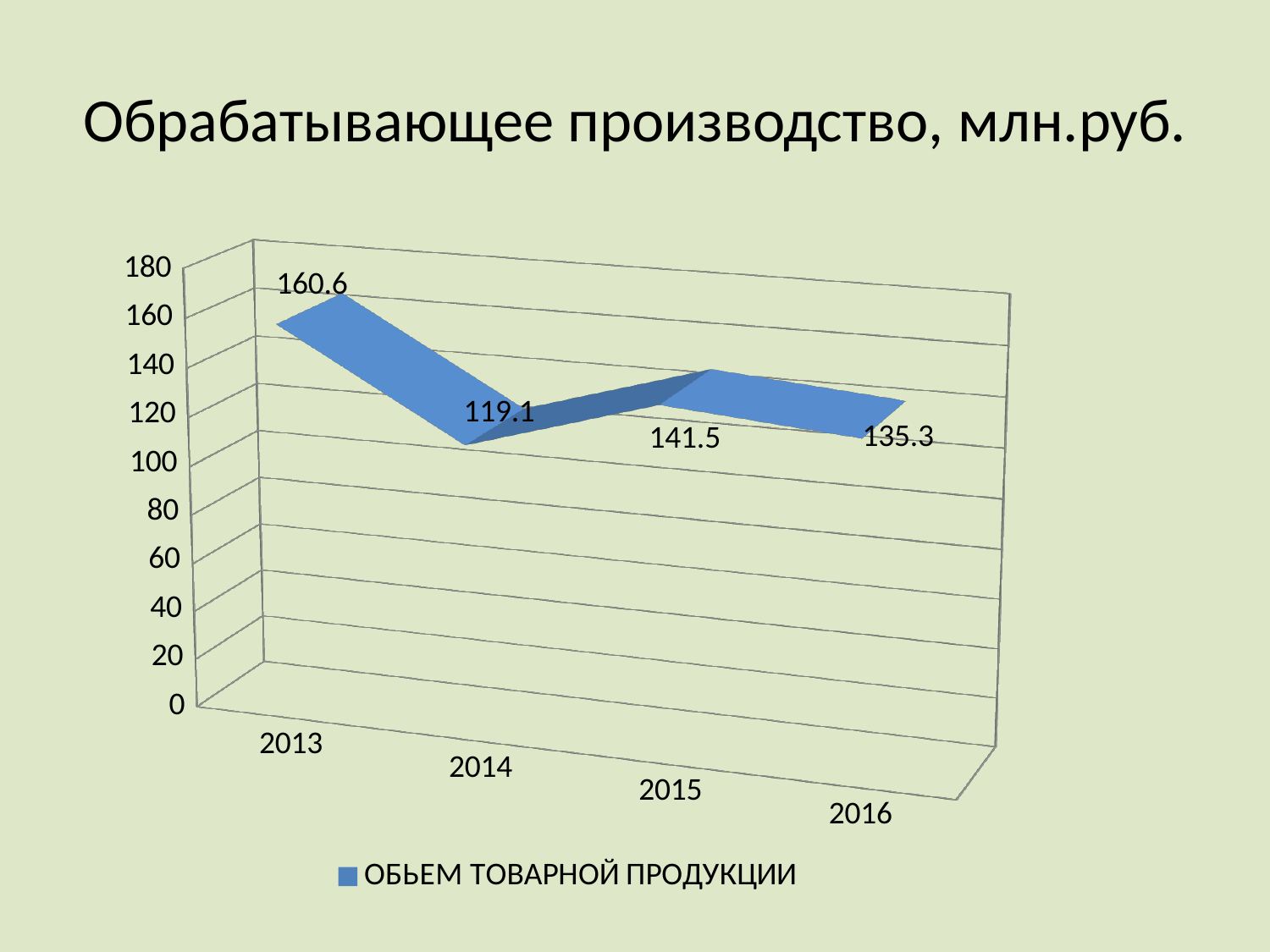
Is the value for 2014 greater or less than 120? less Which year has the lowest value? 2014 What kind of chart is this? line chart How many years are shown on the x axis? 4 What is the value for 2014? 119.1 What is the value for 2015? 141.5 Which year has the highest value? 2013 What is the value for 2016? 135.3 What is the value for 2013? 160.6 What is the title of the chart? Обрабатывающее производство, млн.руб. What is the difference between the values for 2013 and 2014? 41.5 Which is larger, the value for 2015 or the value for 2016? 2015